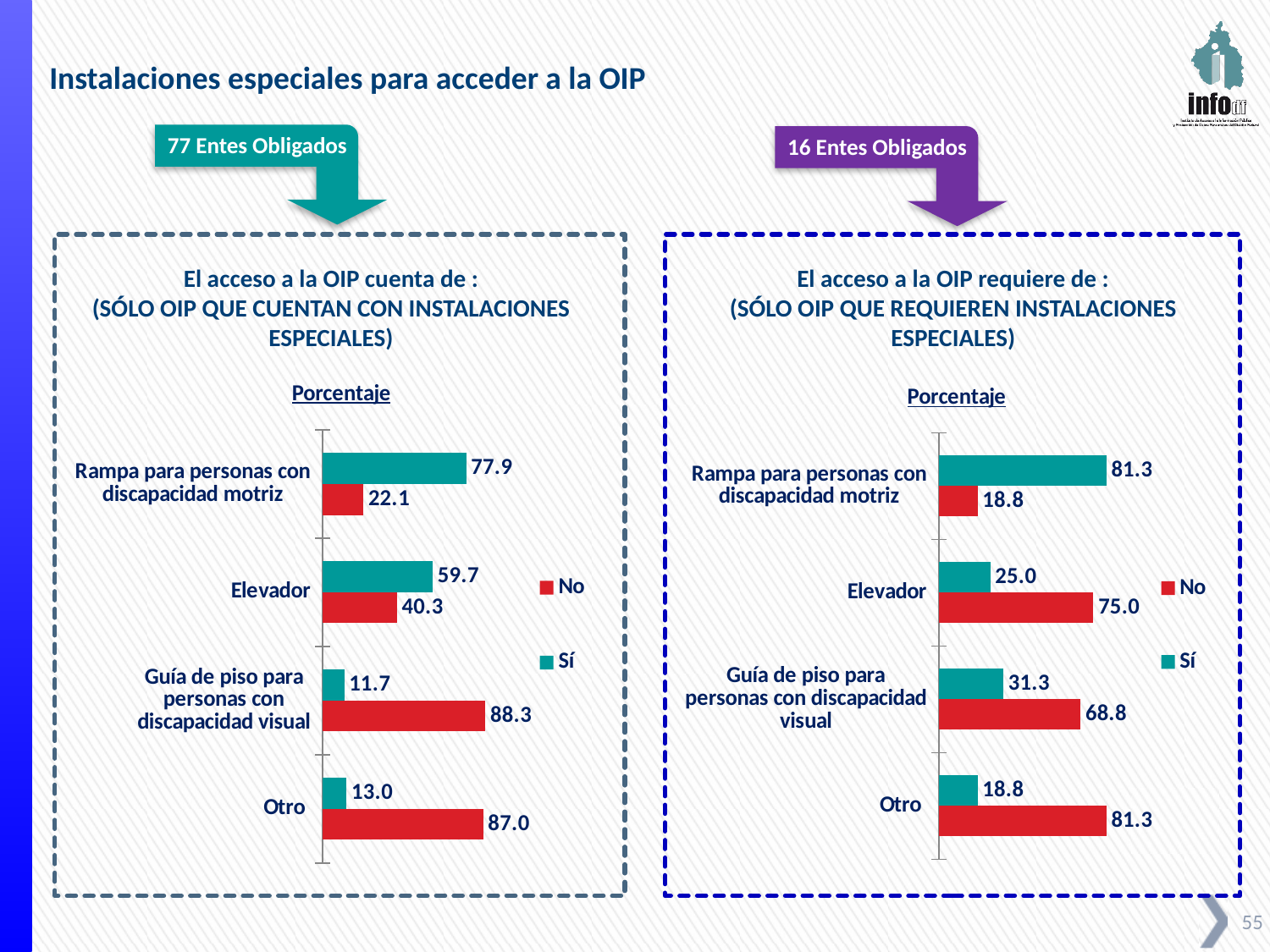
In the right chart (El acceso a la OIP requiere de), what is the 'No' value for Elevador? 75.0 In the right chart (El acceso a la OIP requiere de), what is the difference between the 'Sí' and 'No' values for Rampa para personas con discapacidad motriz? 62.5 How many series does the legend of the right chart (El acceso a la OIP requiere de) list? 2 What type of chart is the left chart (El acceso a la OIP cuenta de)? Bar chart Which colour represents the 'No' series in the left chart (El acceso a la OIP cuenta de)? Red In the right chart (El acceso a la OIP requiere de), which category has the lowest 'Sí' value? Otro In the left chart (El acceso a la OIP cuenta de), which category has the highest 'No' value? Guía de piso para personas con discapacidad visual In the left chart (El acceso a la OIP cuenta de), what is the 'Sí' value for Rampa para personas con discapacidad motriz? 77.9 How many categories are shown in the left chart (El acceso a la OIP cuenta de)? 4 In the left chart (El acceso a la OIP cuenta de), what is the difference between the 'No' and 'Sí' values for Otro? 74.0 In the left chart (El acceso a la OIP cuenta de), what is the 'Sí' value for Elevador? 59.7 In the right chart (El acceso a la OIP requiere de), which is larger for Guía de piso para personas con discapacidad visual: the 'Sí' value or the 'No' value? No